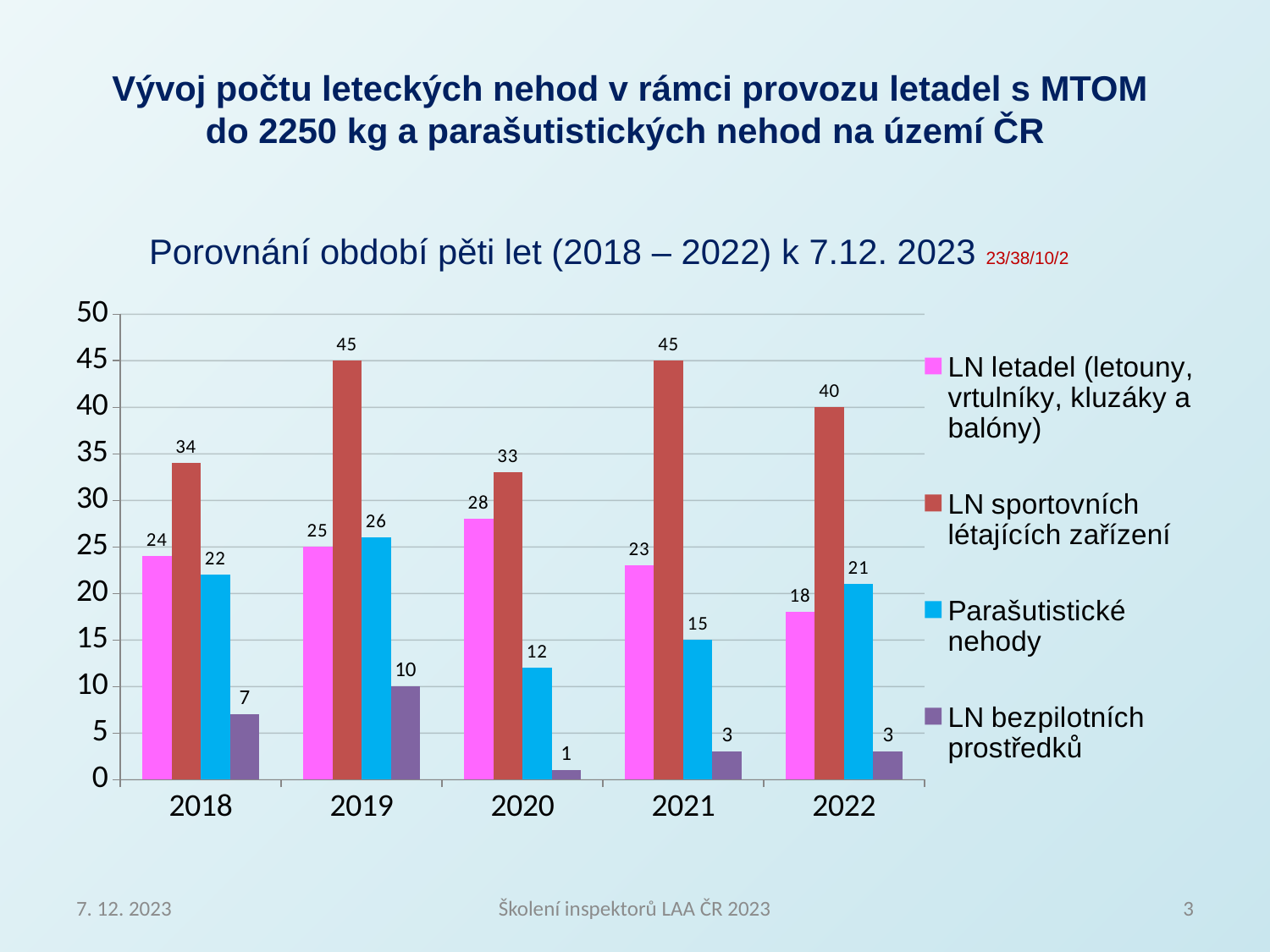
How many years are shown on the x axis? 5 What is the value for Parašutistické nehody in 2020? 12 What kind of chart is shown on the slide? bar chart Is the value for LN sportovních létajících zařízení in 2020 greater or less than 30? greater In which year is the value for LN bezpilotních prostředků lowest? 2020 What is the value for LN bezpilotních prostředků in 2018? 7 In which year is the value for LN letadel (letouny, vrtulníky, kluzáky a balóny) highest? 2020 Which colour represents Parašutistické nehody in the chart? blue What is the value for LN sportovních létajících zařízení in 2019? 45 How many series does the legend list? 4 Which is larger in 2021: Parašutistické nehody or LN letadel (letouny, vrtulníky, kluzáky a balóny)? LN letadel (letouny, vrtulníky, kluzáky a balóny) What is the difference between the LN sportovních létajících zařízení values for 2022 and 2018? 6